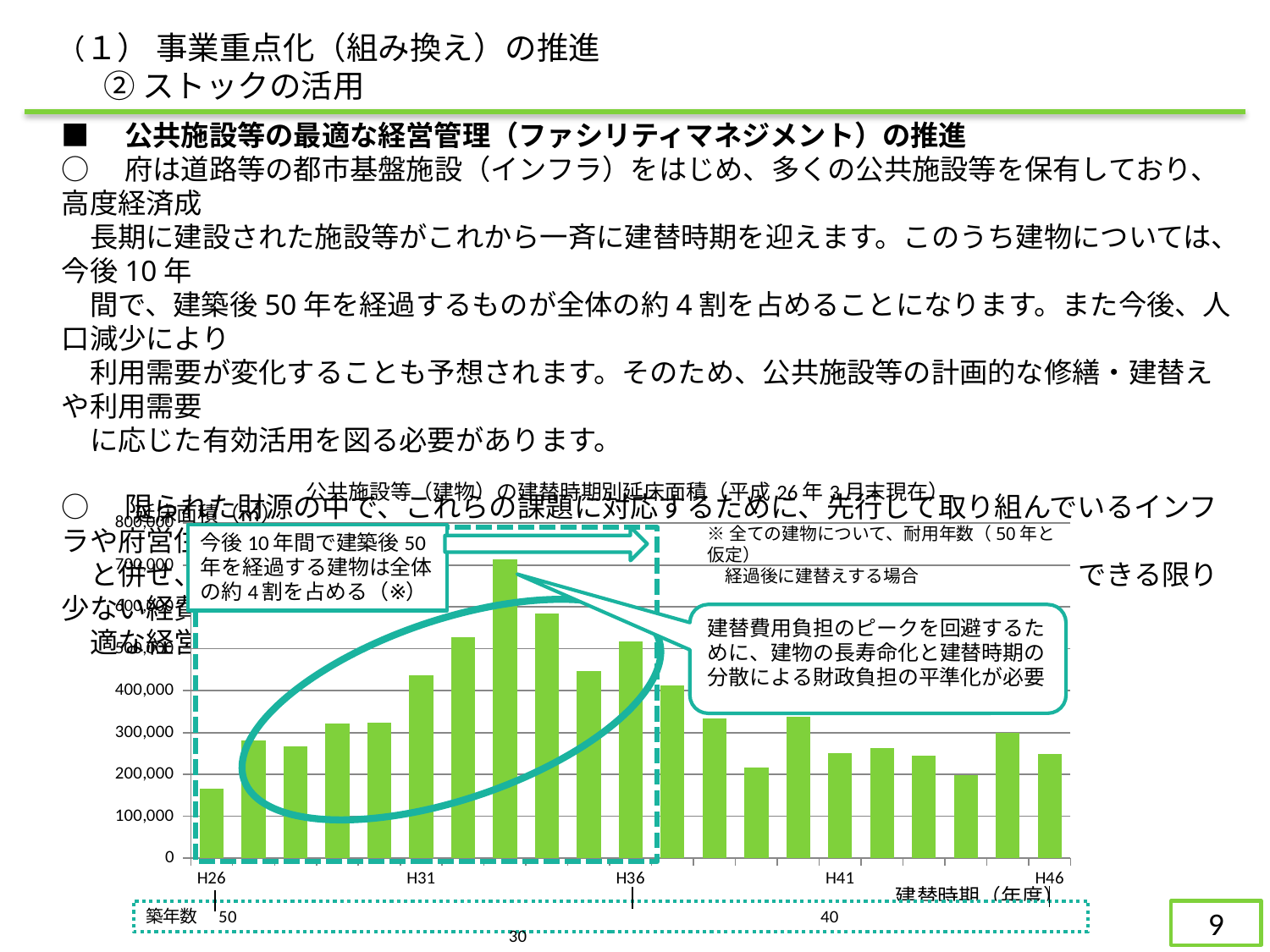
Is the value for H31 greater or less than 400,000? greater How many bars are plotted in the chart? 21 Which has the larger value, H31 or H26? H31 Do the values generally rise or fall from H36 to H46? fall Which has the larger value, H36 or H41? H36 What kind of chart is shown on the slide? bar chart What is the title of the chart? 公共施設等（建物）の建替時期別延床面積（平成26年3月末現在） Is the value for H41 greater or less than 300,000? less Is the value for H26 greater or less than 200,000? less Which labelled year has the lowest bar in the chart? H26